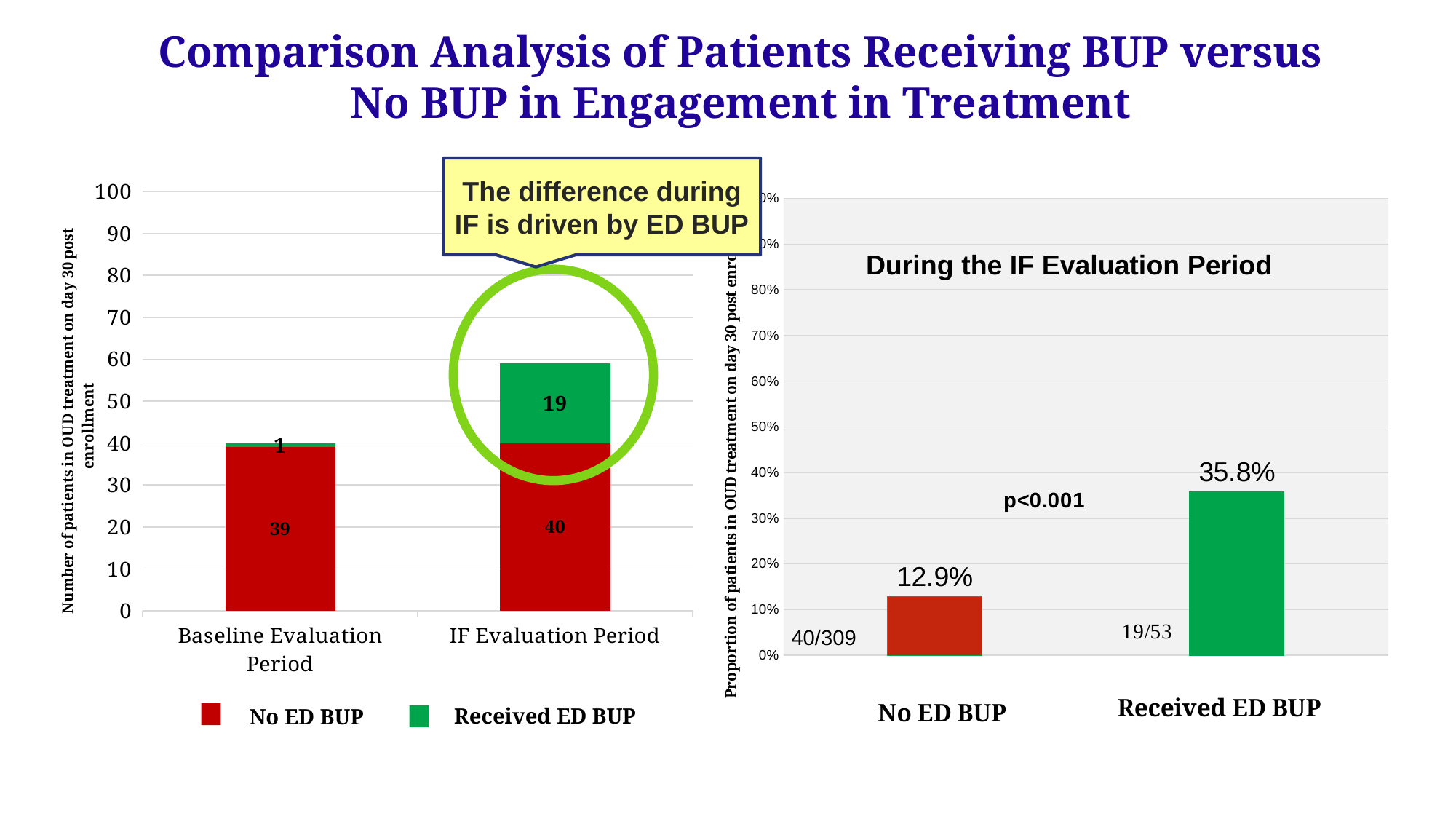
In the right chart titled 'During the IF Evaluation Period', which category has the higher proportion? Received ED BUP In the right chart titled 'During the IF Evaluation Period', what is the proportion for Received ED BUP? 35.8% In the left stacked bar chart, what is the value for Received ED BUP during the IF Evaluation Period? 19 In the left stacked bar chart, what is the difference between the Received ED BUP values for the IF Evaluation Period and the Baseline Evaluation Period? 18 In the left stacked bar chart, what is the value for No ED BUP during the IF Evaluation Period? 40 In the left stacked bar chart, what is the total of the Baseline Evaluation Period bar? 40 In the right chart titled 'During the IF Evaluation Period', what is the proportion for No ED BUP? 12.9% How many series does the legend of the left stacked bar chart list? 2 In the left stacked bar chart, what is the value for Received ED BUP during the Baseline Evaluation Period? 1 What kind of chart is the chart on the right of the slide? Bar chart In the left stacked bar chart, what is the value for No ED BUP during the Baseline Evaluation Period? 39 In the left stacked bar chart, what is the total of the IF Evaluation Period bar? 59